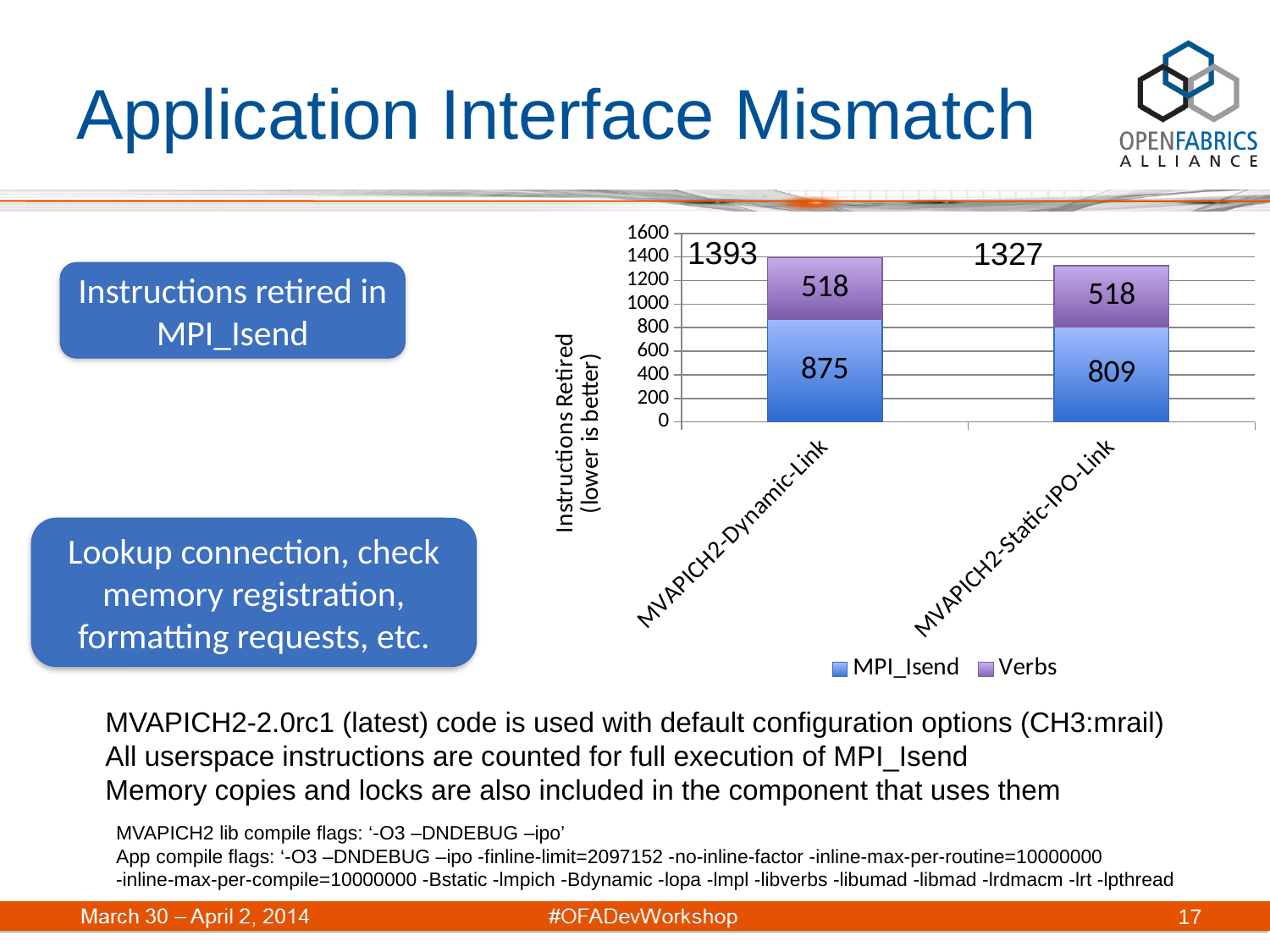
What is the Verbs value for MVAPICH2-Dynamic-Link? 518 Which is larger, the MPI_Isend value for MVAPICH2-Dynamic-Link or for MVAPICH2-Static-IPO-Link? MVAPICH2-Dynamic-Link What is the label of the y axis? Instructions Retired (lower is better) How many series does the legend list? 2 Which category has the lower total instructions retired? MVAPICH2-Static-IPO-Link What is the difference between the MPI_Isend values for MVAPICH2-Dynamic-Link and MVAPICH2-Static-IPO-Link? 66 What is the total instructions retired for the MVAPICH2-Dynamic-Link bar? 1393 What kind of chart is shown on the slide? Stacked bar chart What is the MPI_Isend value for MVAPICH2-Dynamic-Link? 875 What is the MPI_Isend value for MVAPICH2-Static-IPO-Link? 809 What is the total instructions retired for the MVAPICH2-Static-IPO-Link bar? 1327 What is the difference between the total values of the two bars? 66